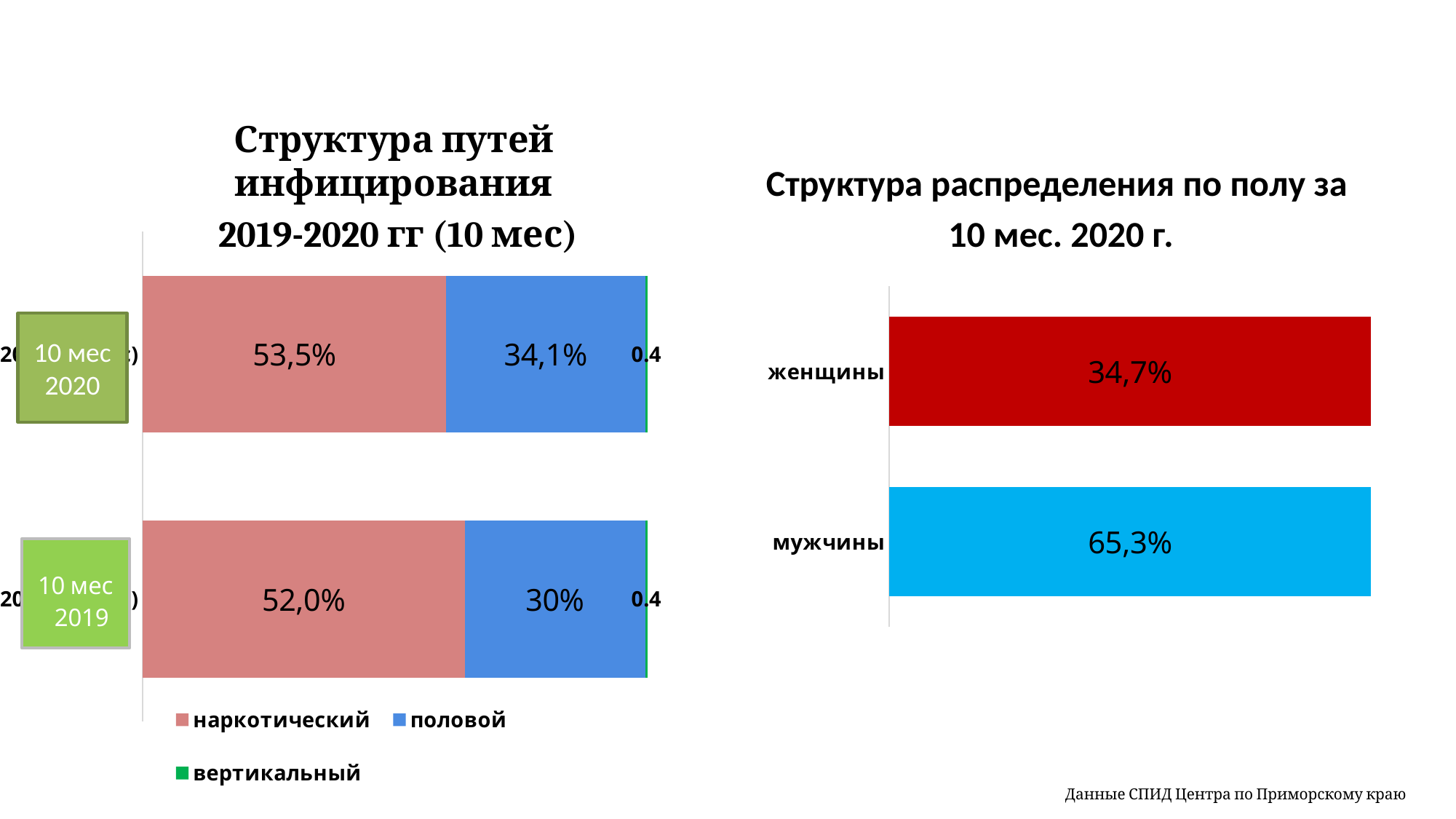
In the chart 'Структура путей инфицирования 2019-2020 гг (10 мес)', what is the value for наркотический for 10 мес 2019? 52,0% In the chart 'Структура распределения по полу за 10 мес. 2020 г.', what is the difference between the values for мужчины and женщины? 30,6% In the chart 'Структура путей инфицирования 2019-2020 гг (10 мес)', what is the value for наркотический for 10 мес 2020? 53,5% In the chart 'Структура распределения по полу за 10 мес. 2020 г.', what is the value for женщины? 34,7% In the chart 'Структура путей инфицирования 2019-2020 гг (10 мес)', how many series does the legend list? 3 In the chart 'Структура путей инфицирования 2019-2020 гг (10 мес)', what is the value for половой for 10 мес 2019? 30% In the chart 'Структура путей инфицирования 2019-2020 гг (10 мес)', what is the difference between the половой values for 10 мес 2020 and 10 мес 2019? 4,1% In the chart 'Структура распределения по полу за 10 мес. 2020 г.', which category has the highest value? мужчины In the chart 'Структура распределения по полу за 10 мес. 2020 г.', what is the value for мужчины? 65,3% In the chart 'Структура путей инфицирования 2019-2020 гг (10 мес)', what kind of chart is it? stacked bar chart In the chart 'Структура путей инфицирования 2019-2020 гг (10 мес)', what is the value for половой for 10 мес 2020? 34,1% In the chart 'Структура путей инфицирования 2019-2020 гг (10 мес)', which is larger: наркотический for 10 мес 2020 or наркотический for 10 мес 2019? 10 мес 2020